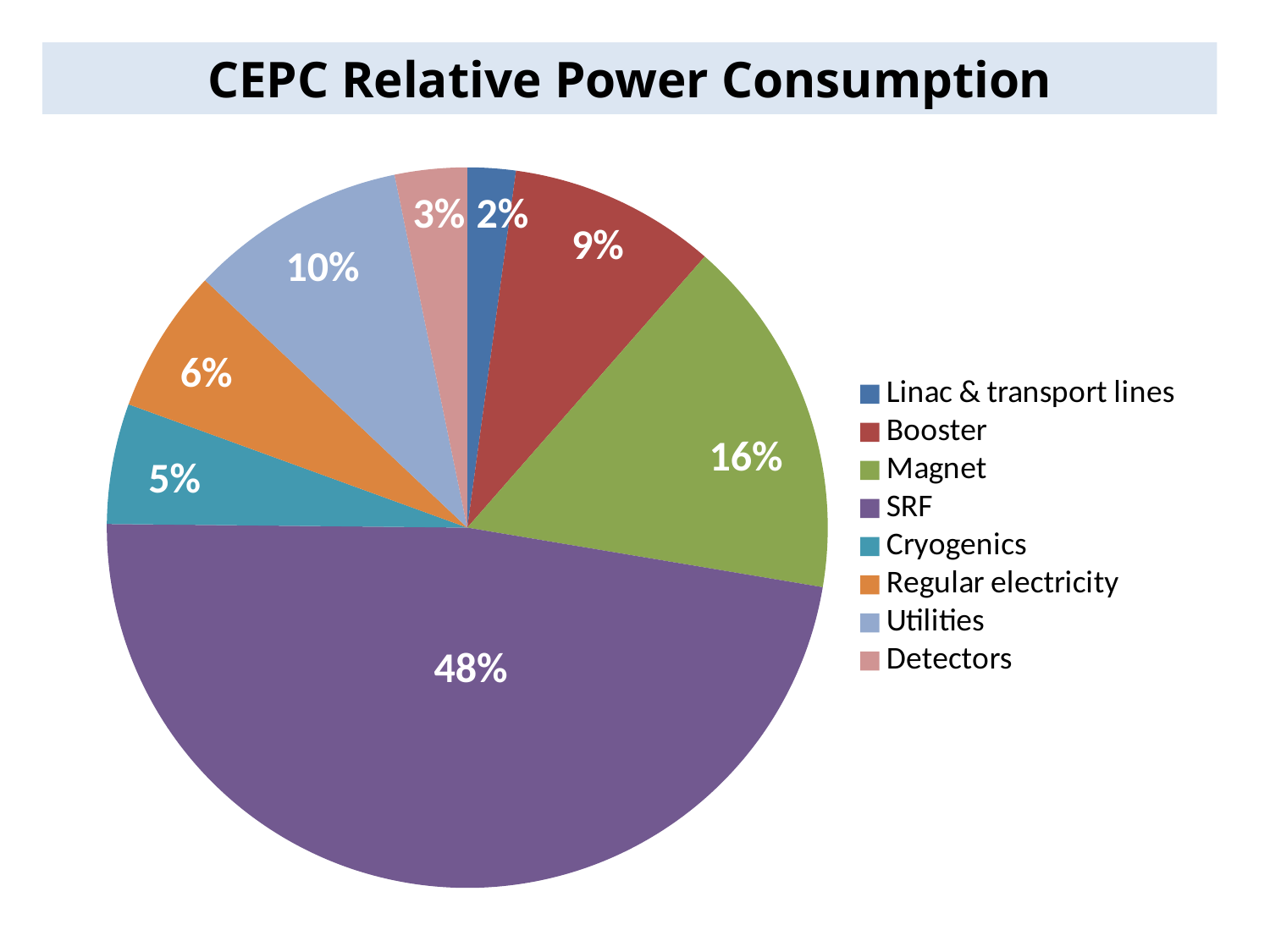
What is the title of the chart? CEPC Relative Power Consumption What type of chart is shown on the slide? pie chart Which category has the smallest share of power consumption? Linac & transport lines What share of power consumption does Magnet account for? 16% Which has a larger share, Regular electricity or Detectors? Regular electricity Which category has the largest share of power consumption? SRF What is the difference in percentage points between the SRF share and the Magnet share? 32 What share of power consumption do Utilities account for? 10% What share of power consumption does Cryogenics account for? 5% What share of power consumption does Booster account for? 9% What share of power consumption does SRF account for? 48% How many categories does the legend list? 8